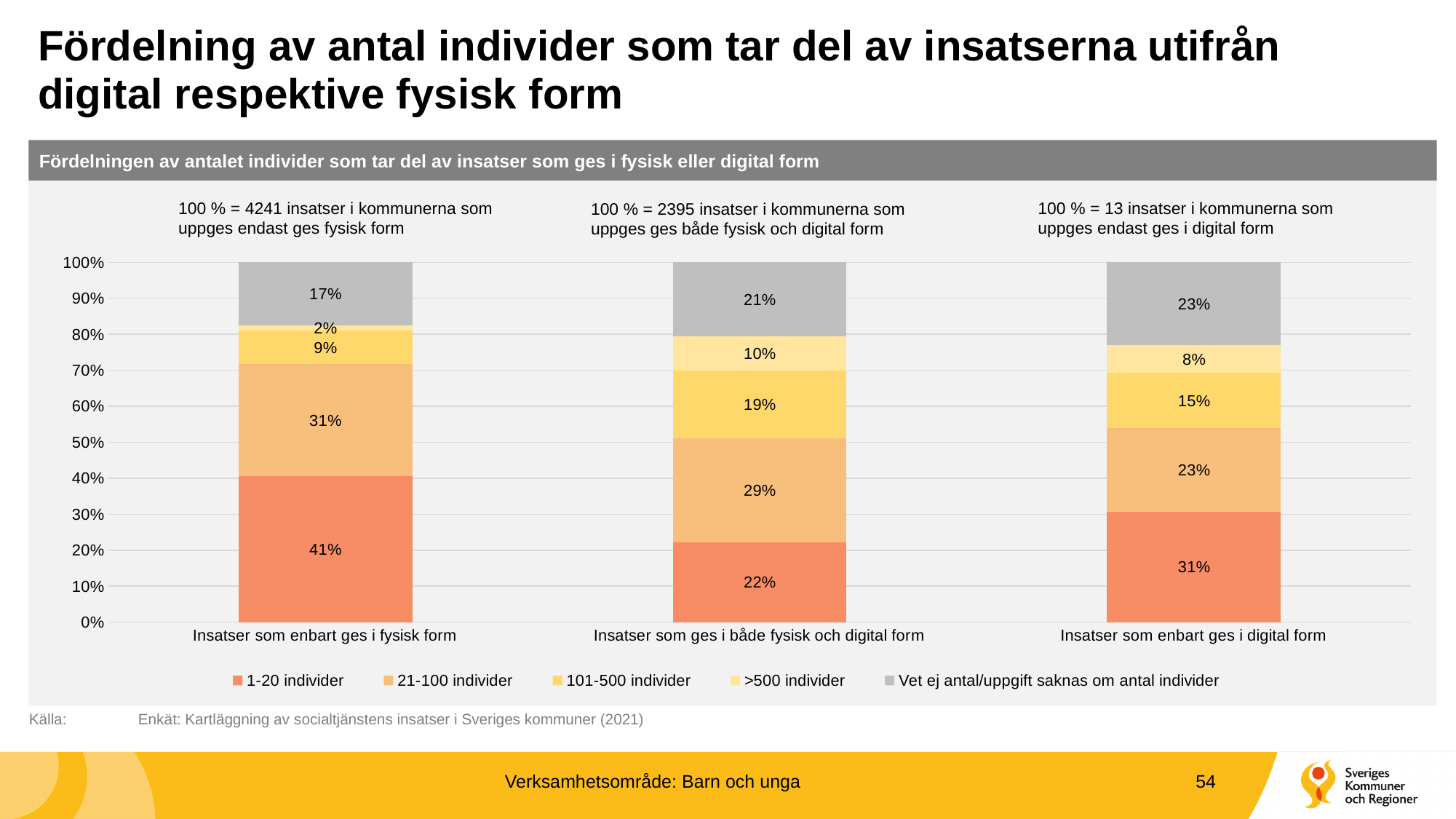
How many categories are shown on the x axis? 3 According to the note above the chart, how many insatser does 100 % correspond to for the category 'Insatser som ges i både fysisk och digital form'? 2395 What kind of chart is shown on the slide? Stacked bar chart What is the value for '1-20 individer' in the category 'Insatser som enbart ges i fysisk form'? 41% How many series does the legend list? 5 What is the value for '101-500 individer' in the category 'Insatser som enbart ges i digital form'? 15% Which category has the highest value for '1-20 individer'? Insatser som enbart ges i fysisk form Which category has the lowest value for '>500 individer'? Insatser som enbart ges i fysisk form Which is larger: the '101-500 individer' value for 'Insatser som ges i både fysisk och digital form' or for 'Insatser som enbart ges i fysisk form'? Insatser som ges i både fysisk och digital form What is the value for '>500 individer' in the category 'Insatser som ges i både fysisk och digital form'? 10% What is the difference between the '21-100 individer' values for 'Insatser som enbart ges i fysisk form' and 'Insatser som enbart ges i digital form'? 8 percentage points What is the value for 'Vet ej antal/uppgift saknas om antal individer' in the category 'Insatser som enbart ges i digital form'? 23%